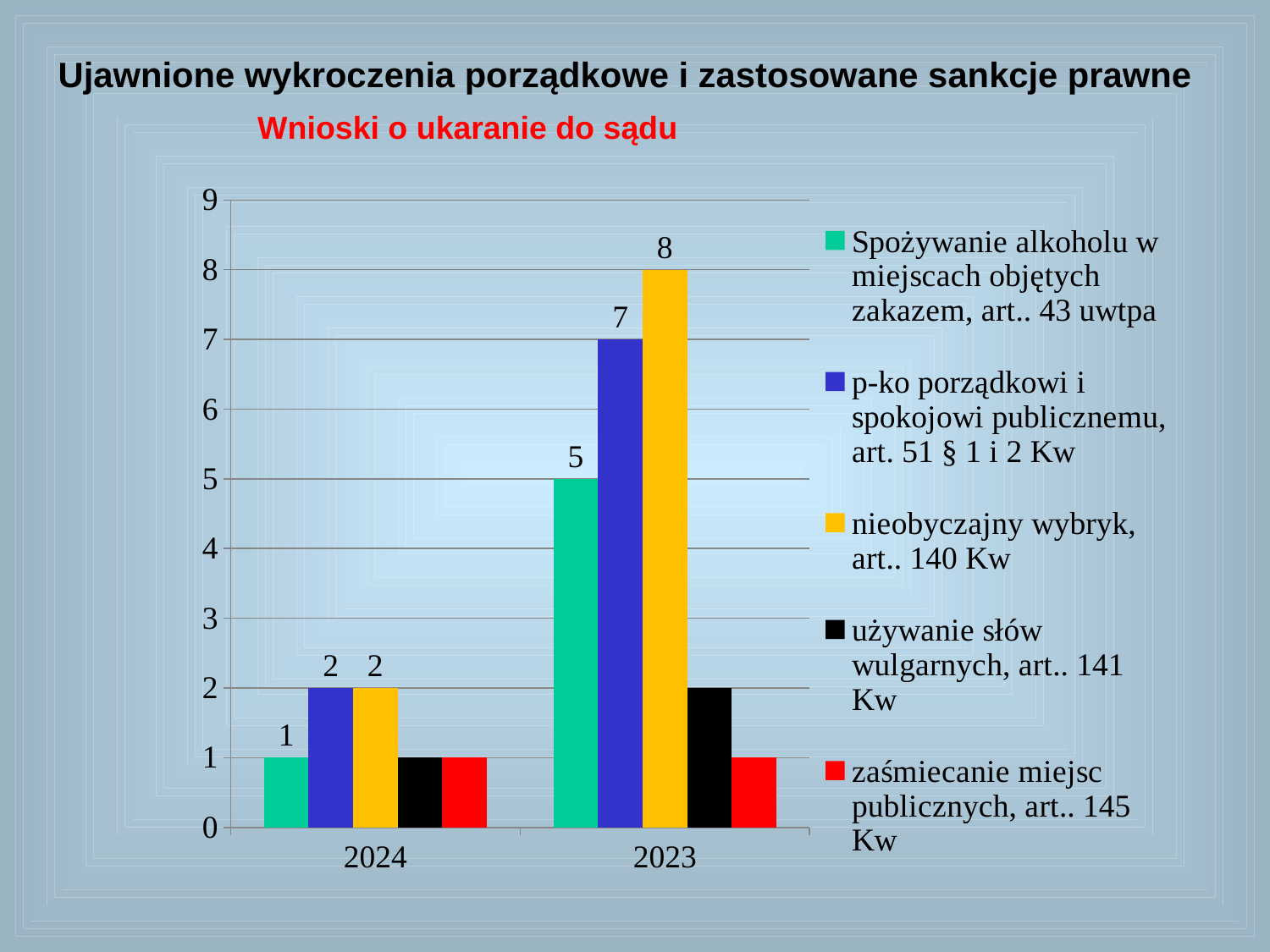
How many series does the legend list? 5 What is the value for 'nieobyczajny wybryk, art.. 140 Kw' in 2023? 8 What is the difference between the 2023 and 2024 values for 'nieobyczajny wybryk, art.. 140 Kw'? 6 What colour represents 'zaśmiecanie miejsc publicznych, art.. 145 Kw' in the chart? red What type of chart is shown on the slide? bar chart What is the difference between the 2023 and 2024 values for 'p-ko porządkowi i spokojowi publicznemu, art. 51 § 1 i 2 Kw'? 5 What is the value for 'Spożywanie alkoholu w miejscach objętych zakazem, art.. 43 uwtpa' in 2024? 1 What is the value for 'używanie słów wulgarnych, art.. 141 Kw' in 2023? 2 How many categories are shown on the x axis? 2 Which is larger: the 2023 value for 'Spożywanie alkoholu w miejscach objętych zakazem, art.. 43 uwtpa' or the 2023 value for 'p-ko porządkowi i spokojowi publicznemu, art. 51 § 1 i 2 Kw'? p-ko porządkowi i spokojowi publicznemu, art. 51 § 1 i 2 Kw Which series has the highest value in 2023? nieobyczajny wybryk, art.. 140 Kw What is the value for 'p-ko porządkowi i spokojowi publicznemu, art. 51 § 1 i 2 Kw' in 2023? 7